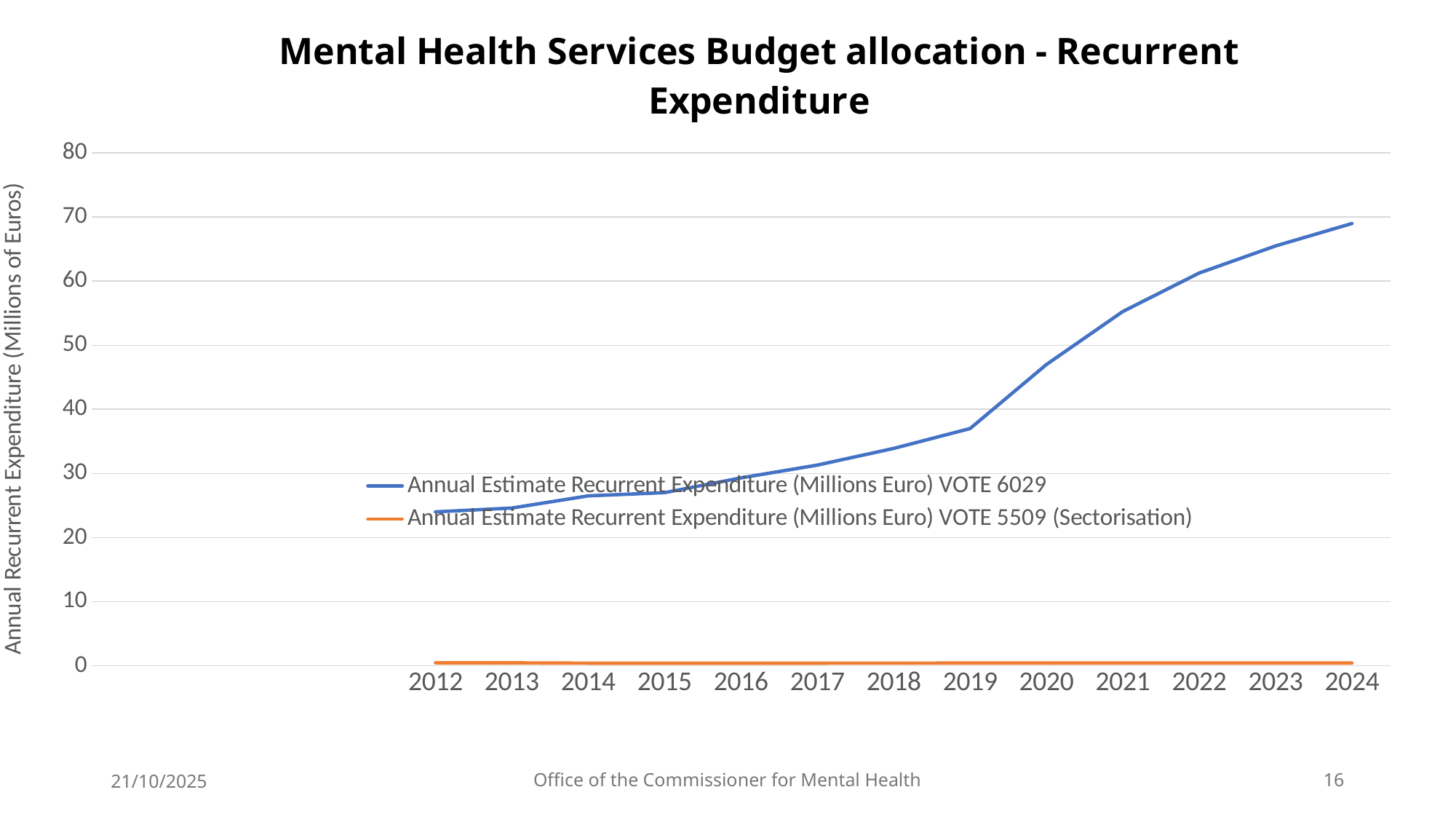
Which is larger, the VOTE 6029 value for 2020 or for 2015? 2020 In which year is the VOTE 6029 value lowest? 2012 How many years are shown along the x axis? 13 How many series does the legend list? 2 In which year is the VOTE 6029 value highest? 2024 Does the VOTE 6029 series rise or fall from 2012 to 2024? Rises Is the VOTE 6029 value for 2019 greater or less than 40? less Is the VOTE 6029 value for 2024 greater or less than 60? greater What is the label on the vertical axis? Annual Recurrent Expenditure (Millions of Euros) Is the VOTE 6029 value for 2021 greater or less than 50? greater What kind of chart is shown on the slide? Line chart